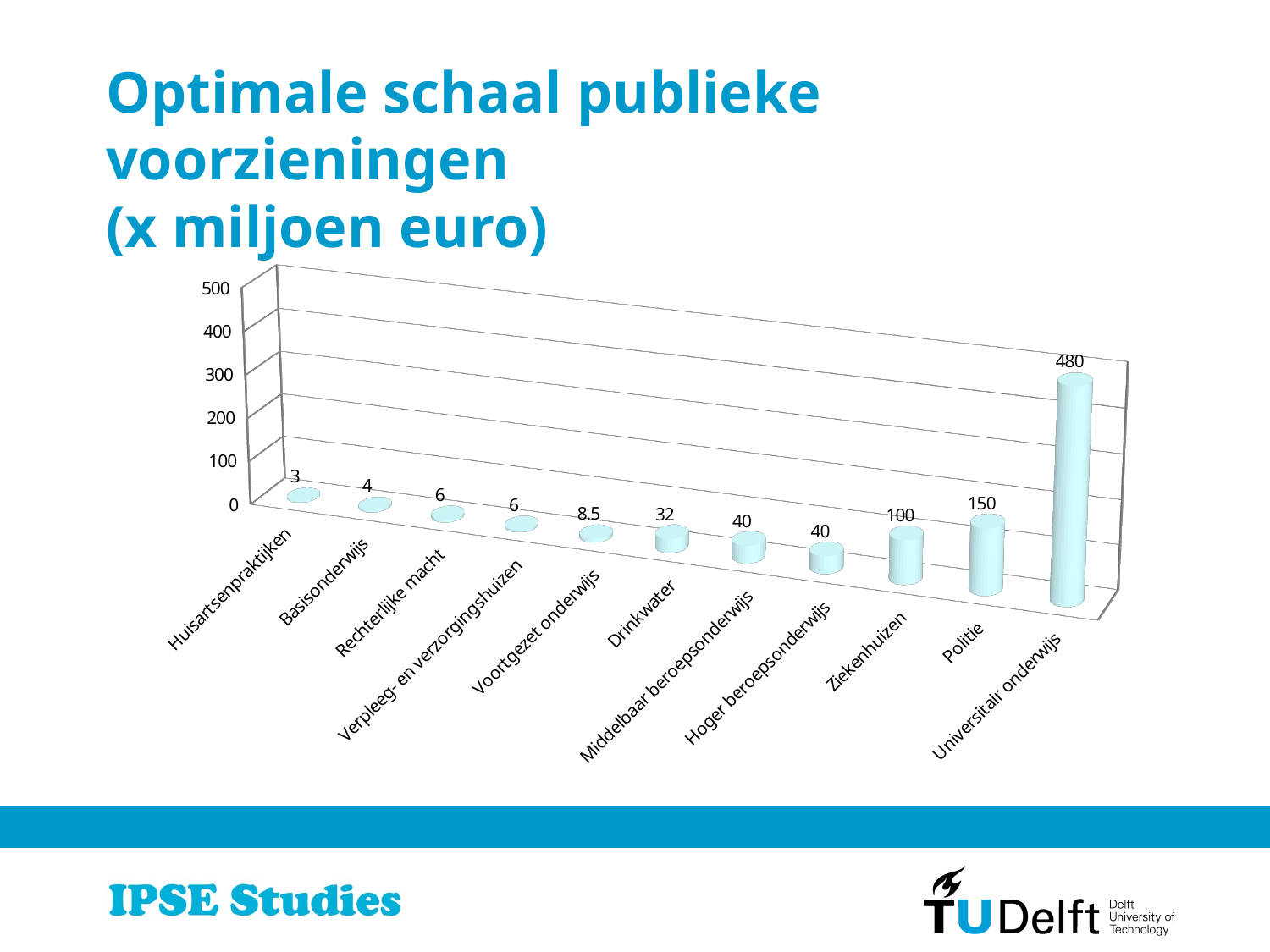
What is the value for Politie? 150 What kind of chart is shown on the slide? Bar chart How many categories are shown in the chart? 11 What is the value for Universitair onderwijs? 480 What is the value for Drinkwater? 32 Do the values rise or fall from left to right along the x axis? Rise What is the difference between the values for Ziekenhuizen and Drinkwater? 68 Which category has the highest value? Universitair onderwijs What is the difference between the values for Universitair onderwijs and Politie? 330 What is the value for Voortgezet onderwijs? 8.5 Which category has the lowest value? Huisartsenpraktijken Which is larger, the value for Ziekenhuizen or the value for Hoger beroepsonderwijs? Ziekenhuizen